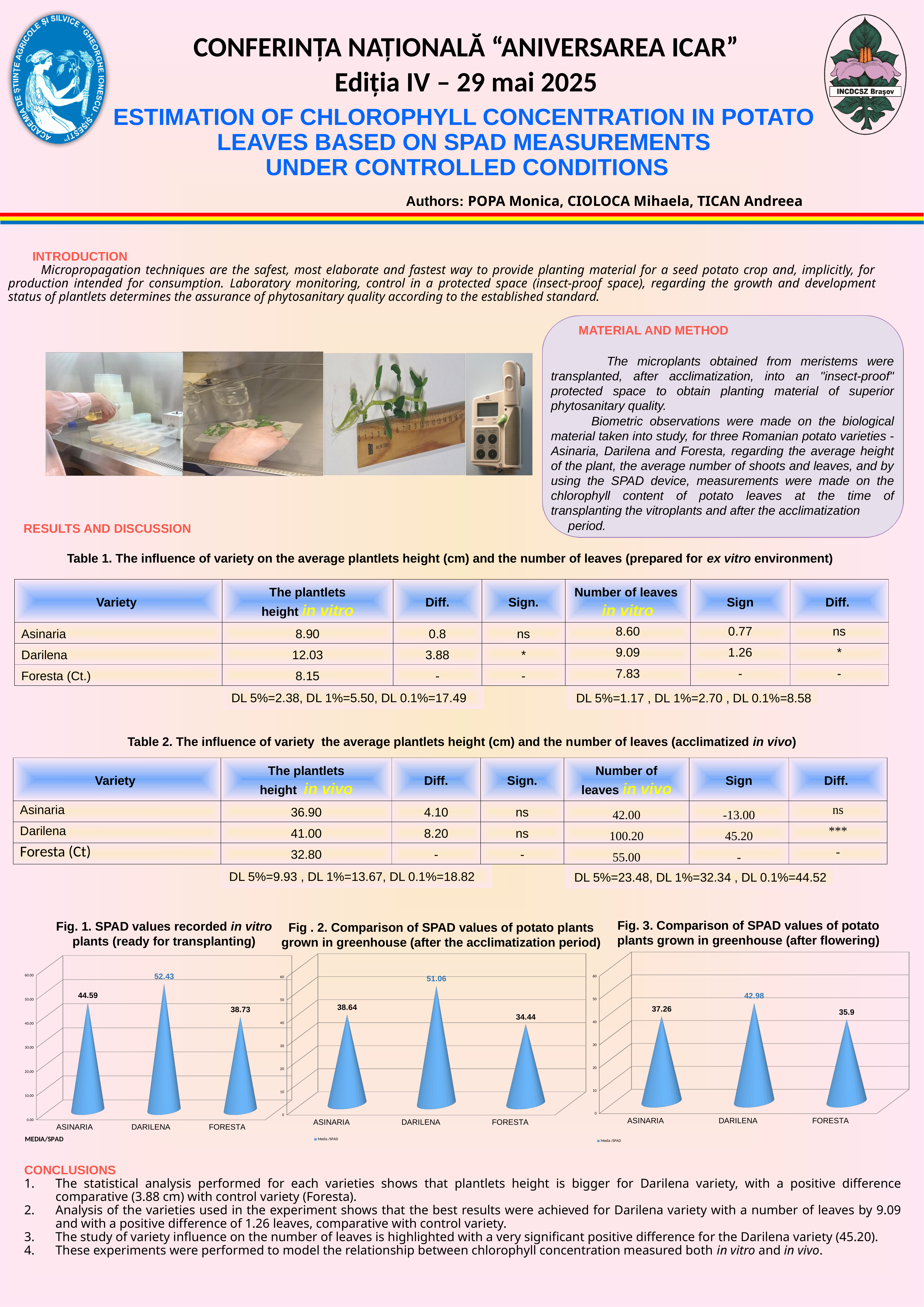
How many varieties are plotted in Fig. 1 (SPAD values recorded in vitro plants)? 3 In Fig. 3 (SPAD values after flowering), which is larger, the value for ASINARIA or the value for DARILENA? DARILENA In Fig. 3 (SPAD values after flowering), what is the value for FORESTA? 35.9 How many series does the legend of Fig. 3 (SPAD values after flowering) list? 1 In Fig. 3 (SPAD values after flowering), what is the difference between the values for DARILENA and FORESTA? 7.08 In Fig. 1 (SPAD values recorded in vitro plants), which variety has the lowest SPAD value? FORESTA In Fig. 2 (SPAD values after the acclimatization period), which variety has the highest SPAD value? DARILENA What kind of chart is Fig. 2 (SPAD values after the acclimatization period)? bar chart In Fig. 2 (SPAD values after the acclimatization period), is the value for FORESTA greater or less than 40? less In Fig. 1 (SPAD values recorded in vitro plants), what is the difference between the values for DARILENA and ASINARIA? 7.84 In Fig. 2 (SPAD values after the acclimatization period), what is the value for ASINARIA? 38.64 In Fig. 1 (SPAD values recorded in vitro plants), what is the value for DARILENA? 52.43